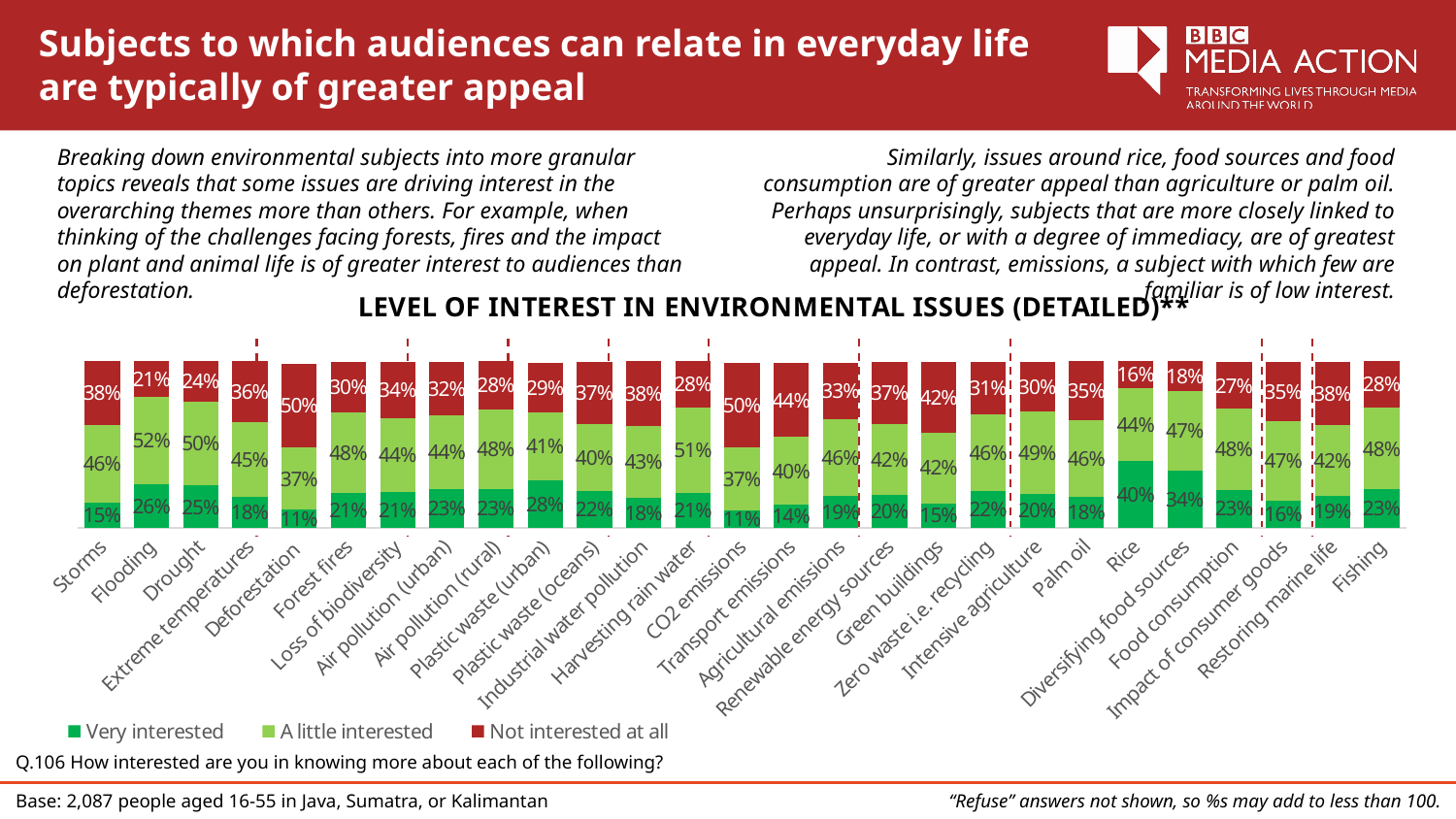
Which has a larger share of very interested respondents, Flooding or Transport emissions? Flooding What is the difference between the very interested percentages for Rice and Storms? 25 percentage points What percentage of respondents are not interested at all in Deforestation? 50% What percentage of respondents are a little interested in Flooding? 52% Which subject has the highest share of respondents who are very interested? Rice How many subjects are shown on the x axis of the chart? 27 What percentage of respondents are very interested in Rice? 40% What kind of chart is shown on the slide? Stacked bar chart What is the total of the three segments for the Flooding bar? 99% Which subject has the lowest share of respondents who are not interested at all? Rice What is the title of the chart? LEVEL OF INTEREST IN ENVIRONMENTAL ISSUES (DETAILED)** How many series does the legend list? 3